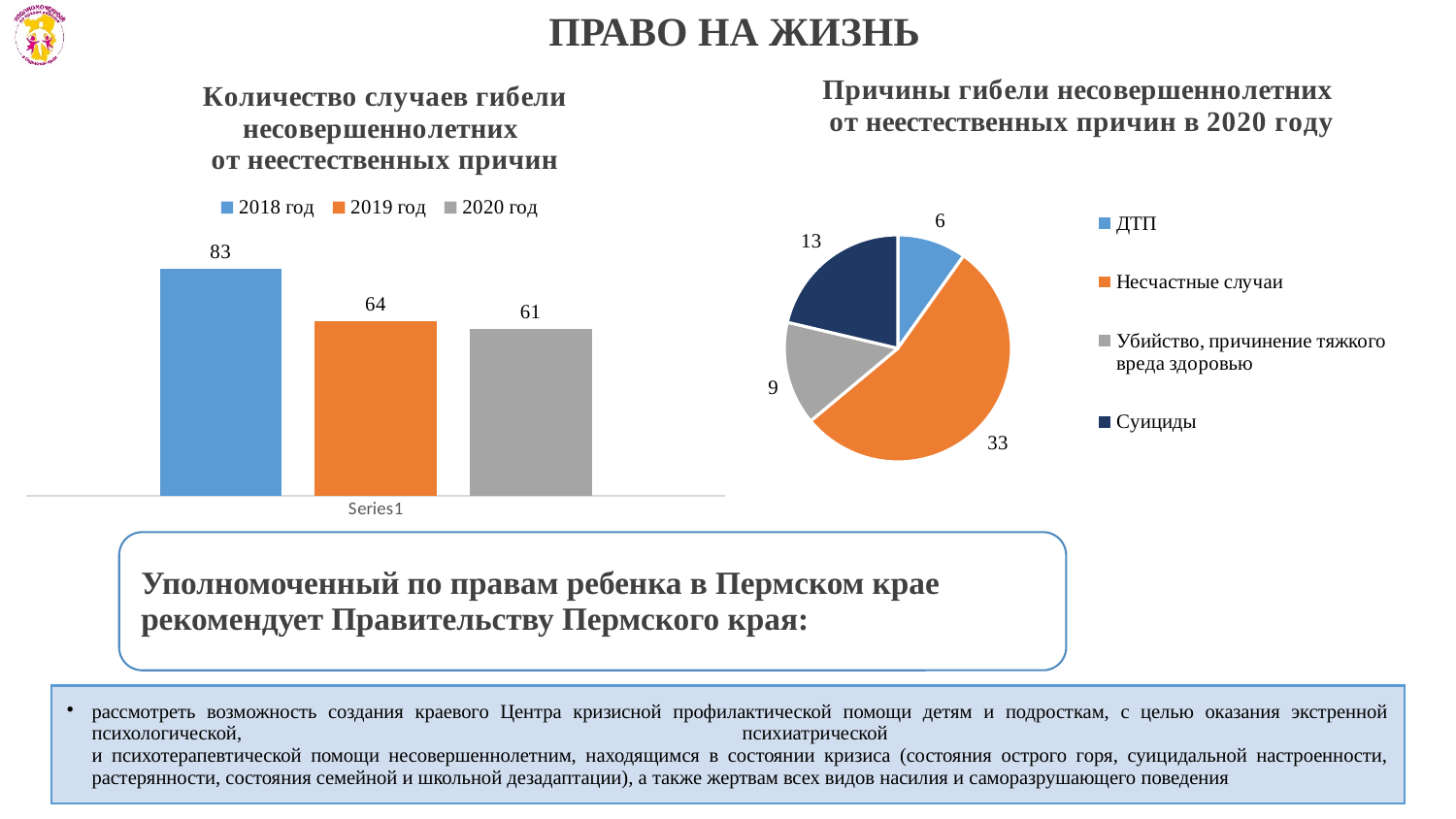
In the bar chart on the left, do the values rise or fall from 2018 год to 2020 год? fall In the bar chart on the left, which year has the lowest value? 2020 год In the bar chart 'Количество случаев гибели несовершеннолетних от неестественных причин', what is the value for 2020 год? 61 How many categories does the pie chart on the right show? 4 How many series does the legend of the bar chart on the left list? 3 In the bar chart 'Количество случаев гибели несовершеннолетних от неестественных причин', what is the value for 2018 год? 83 What kind of chart is the chart on the left of the slide? bar chart In the pie chart 'Причины гибели несовершеннолетних от неестественных причин в 2020 году', what is the value for Суициды? 13 In the pie chart on the right, which is larger: ДТП or Убийство, причинение тяжкого вреда здоровью? Убийство, причинение тяжкого вреда здоровью In the bar chart on the left, which year has the highest value? 2018 год In the bar chart on the left, what is the difference between the values for 2018 год and 2019 год? 19 In the pie chart on the right, which category has the largest slice? Несчастные случаи